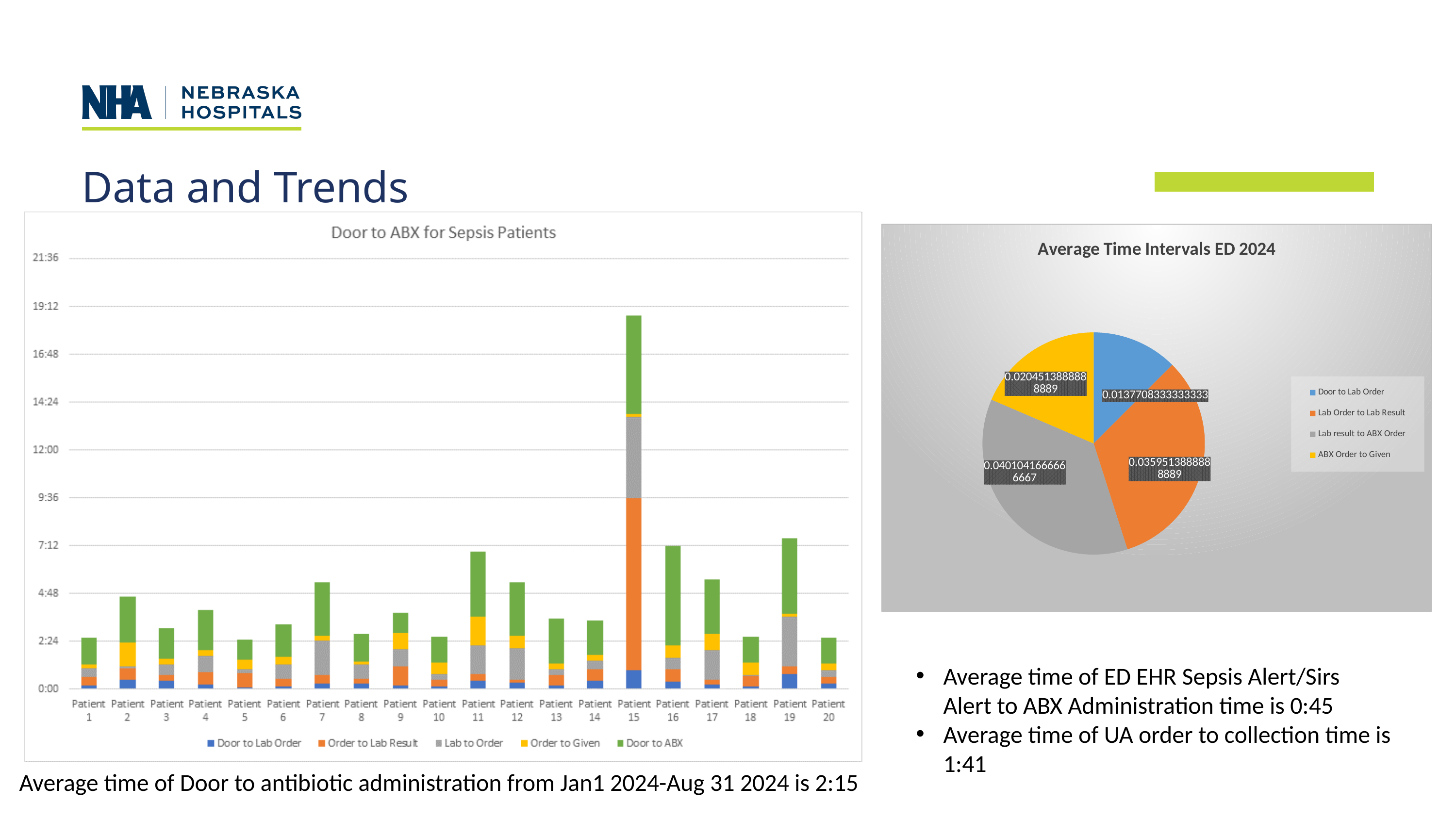
How many series does the legend of the 'Door to ABX for Sepsis Patients' chart list? 5 In the 'Average Time Intervals ED 2024' pie chart, what is the value shown for ABX Order to Given? 0.0204513888888889 In the 'Average Time Intervals ED 2024' pie chart, which is larger: Lab Order to Lab Result or ABX Order to Given? Lab Order to Lab Result In the 'Average Time Intervals ED 2024' pie chart, what is the value shown for Door to Lab Order? 0.0137708333333333 What type of chart is 'Door to ABX for Sepsis Patients'? Stacked bar chart In the 'Average Time Intervals ED 2024' pie chart, which interval has the smallest slice? Door to Lab Order In the 'Door to ABX for Sepsis Patients' chart, is the total for Patient 7 greater or less than 4:48? greater In the 'Door to ABX for Sepsis Patients' chart, which patient has the tallest stacked bar? Patient 15 How many slices does the 'Average Time Intervals ED 2024' pie chart have? 4 In the 'Door to ABX for Sepsis Patients' chart, is the total for Patient 15 greater or less than 16:48? greater In the 'Average Time Intervals ED 2024' pie chart, which interval has the largest slice? Lab result to ABX Order In the 'Average Time Intervals ED 2024' pie chart, what is the value shown for Lab result to ABX Order? 0.0401041666666667